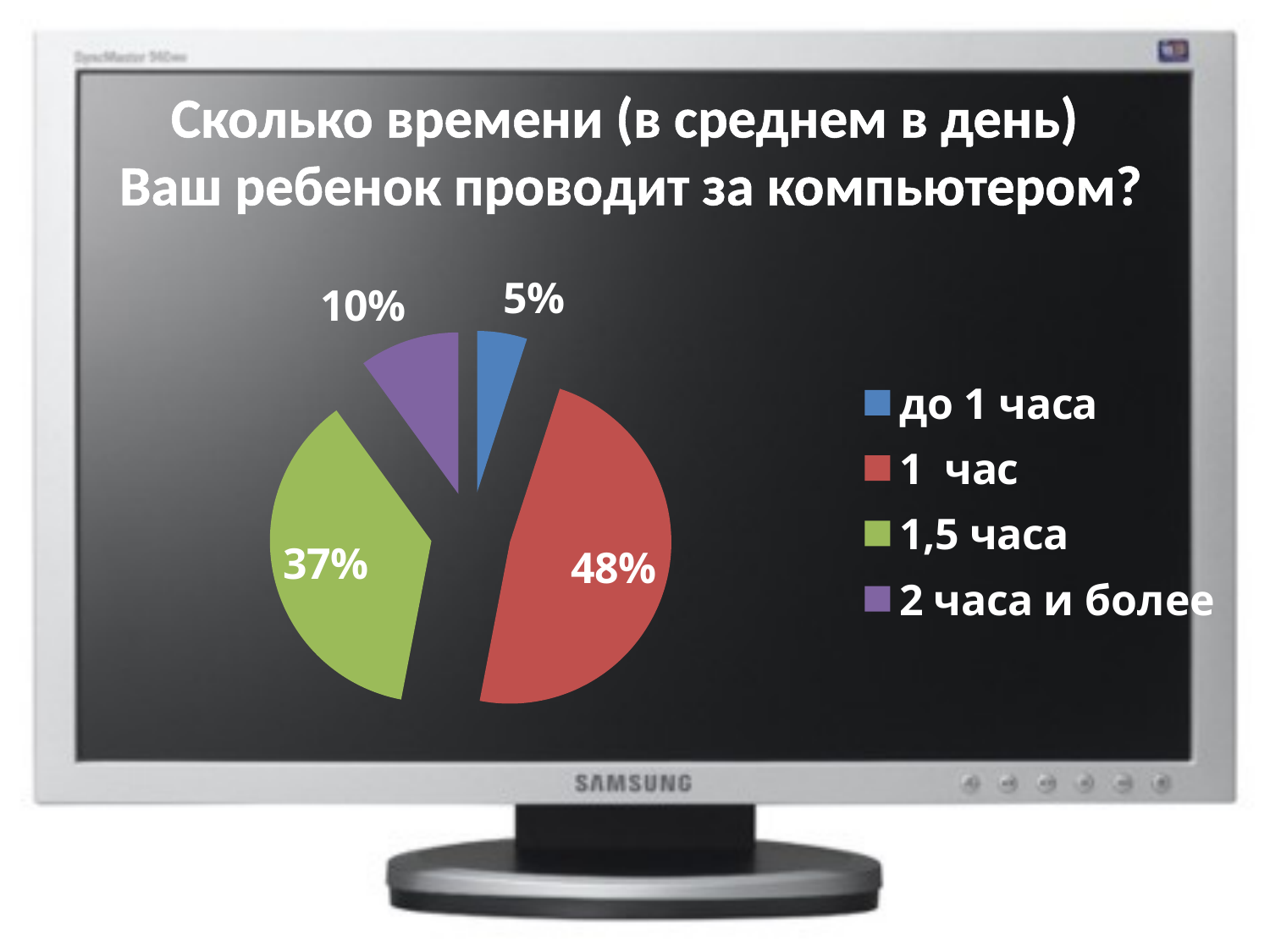
What is the difference in percentage points between the "1 час" slice and the "1,5 часа" slice? 11 What share of the pie is labelled "1 час"? 48% Which slice is larger: "2 часа и более" or "до 1 часа"? 2 часа и более How many slices does the pie chart have? 4 Which category has the largest slice of the pie? 1 час What colour is the slice for "1,5 часа"? green What share of the pie is labelled "1,5 часа"? 37% What is the title of the chart? Сколько времени (в среднем в день) Ваш ребенок проводит за компьютером? Which category has the smallest slice of the pie? до 1 часа What share of the pie is labelled "до 1 часа"? 5% What kind of chart is shown on the slide? pie chart What share of the pie is labelled "2 часа и более"? 10%